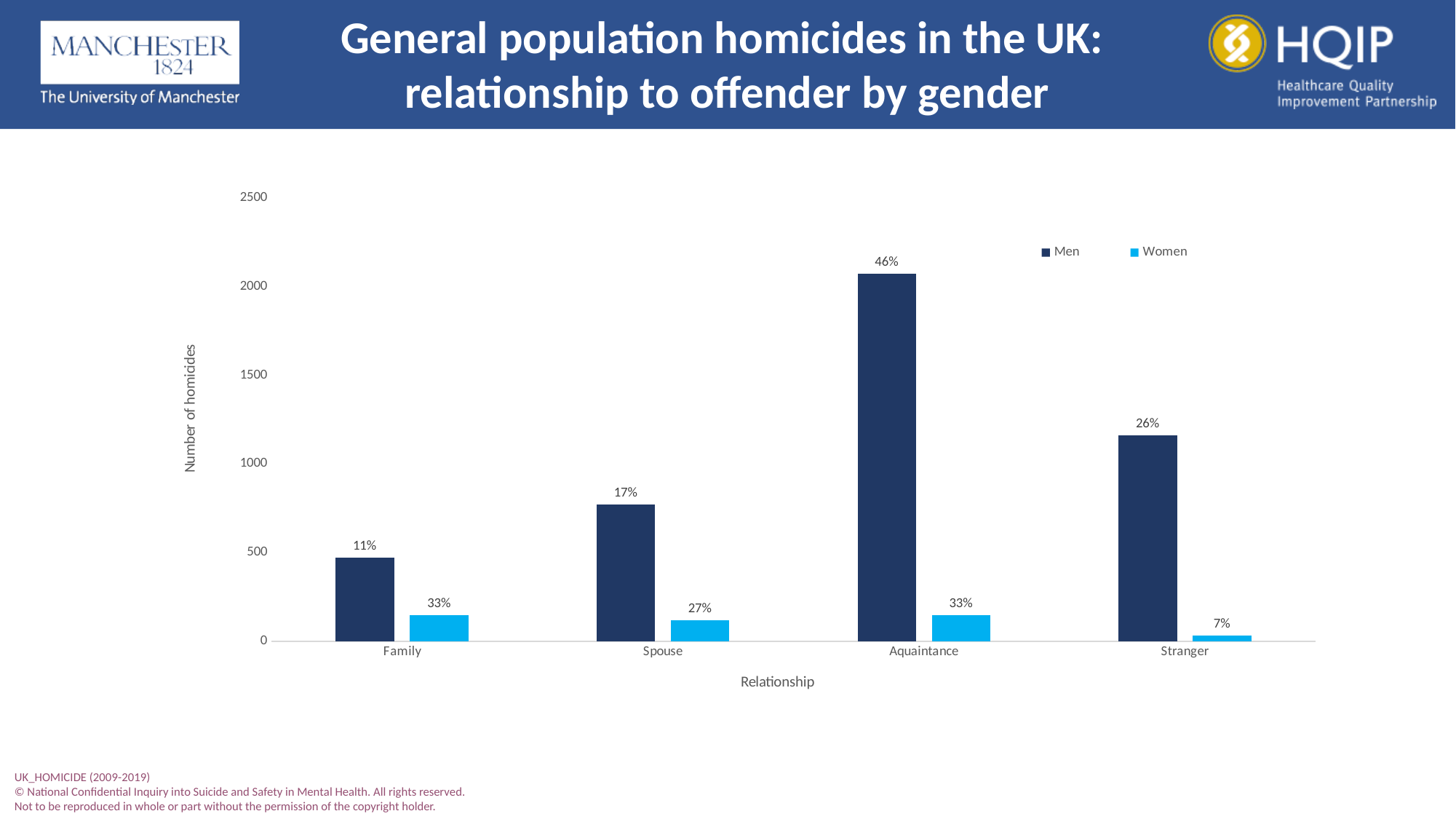
What percentage label is shown above the Men bar for Family? 11% Which is larger for Men: the Spouse bar or the Stranger bar? Stranger For which relationship category is the Men bar highest? Aquaintance What percentage label is shown above the Women bar for Stranger? 7% What percentage label is shown above the Men bar for Aquaintance? 46% How many series does the legend list? 2 What percentage label is shown above the Women bar for Spouse? 27% Is the number of homicides for Men in the Aquaintance category greater or less than 2000? greater What type of chart is shown on the slide? Bar chart For which relationship category is the Women bar lowest? Stranger How many relationship categories are shown on the x axis? 4 What is the title of the y axis? Number of homicides